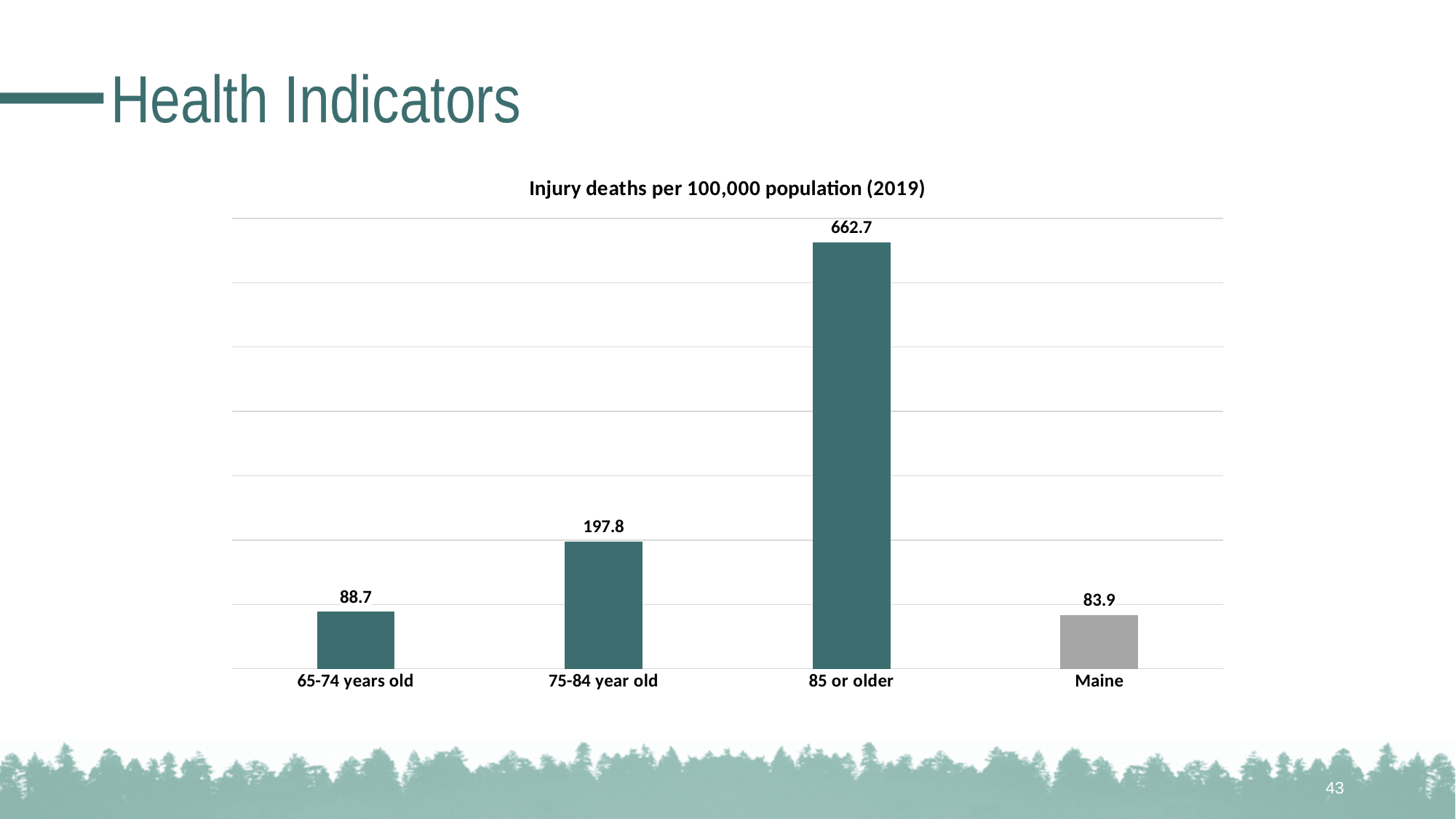
What is the value for 85 or older? 662.7 Which is larger, the value for 75-84 year old or the value for 65-74 years old? 75-84 year old Which category has the lowest value? Maine Which category has the highest value? 85 or older What kind of chart is shown on the slide? Bar chart What is the value for 65-74 years old? 88.7 What is the value for Maine? 83.9 What is the difference between the values for 65-74 years old and Maine? 4.8 What is the difference between the values for 85 or older and 75-84 year old? 464.9 What is the value for 75-84 year old? 197.8 How many categories are shown on the chart? 4 What is the title of the chart? Injury deaths per 100,000 population (2019)